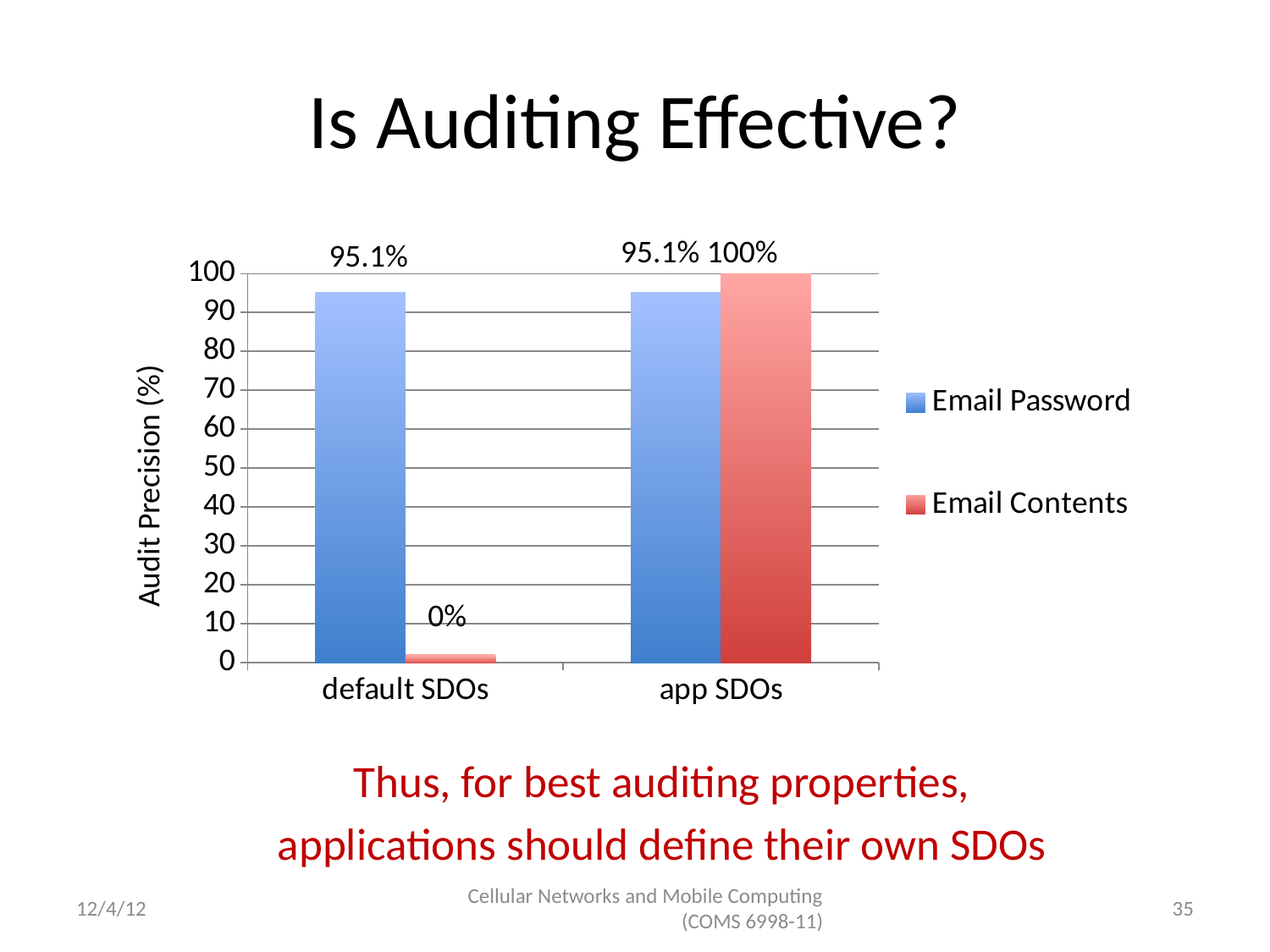
For app SDOs, which series has the higher Audit Precision, Email Password or Email Contents? Email Contents Which category has the highest Audit Precision for Email Contents? app SDOs Is the Audit Precision for Email Password with default SDOs greater or less than 90? greater What is the Audit Precision for Email Contents with default SDOs? 0% What is the Audit Precision for Email Contents with app SDOs? 100% What is the Audit Precision for Email Password with app SDOs? 95.1% What is the difference in Audit Precision for Email Contents between app SDOs and default SDOs? 100 percentage points What kind of chart is shown on the slide? Bar chart How many series does the legend list? 2 What is the Audit Precision for Email Password with default SDOs? 95.1% How many categories are shown on the x axis? 2 Which category has the lowest Audit Precision for Email Contents? default SDOs